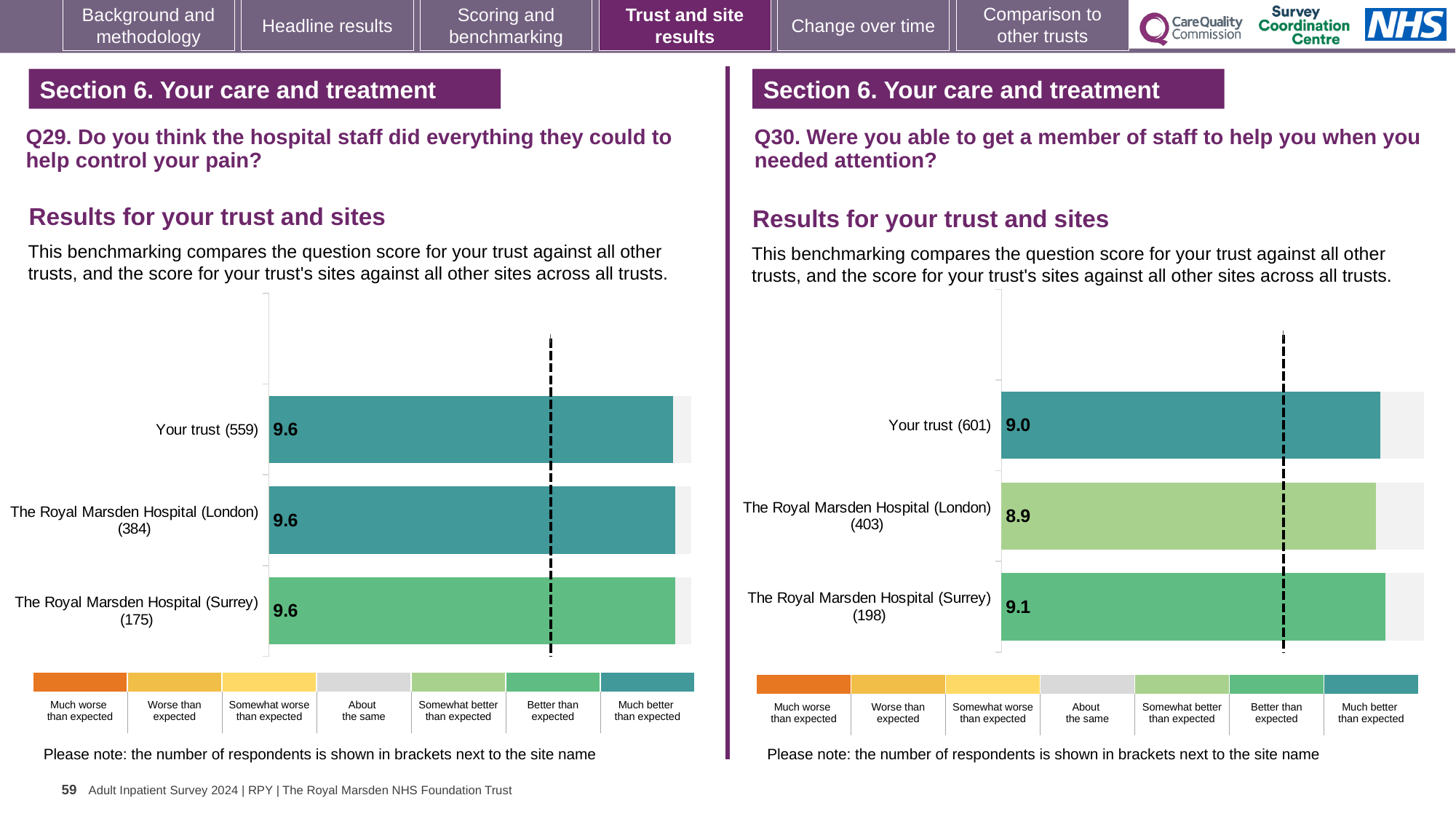
In the Q30 chart on the right, what is the score for Your trust (601)? 9.0 How many bars are plotted in the Q29 chart on the left? 3 In the Q30 chart on the right, which site or trust has the lowest score? The Royal Marsden Hospital (London) (403) In the Q30 chart on the right, what is the score for The Royal Marsden Hospital (London) (403)? 8.9 In the Q30 chart on the right, what is the difference between the Surrey score and the London score? 0.2 In the Q29 chart on the left, what is the score for The Royal Marsden Hospital (Surrey) (175)? 9.6 In the Q30 chart on the right, which benchmark category does the colour of the London bar correspond to according to the legend? Somewhat better than expected In the Q29 chart on the left, what is the score for Your trust (559)? 9.6 What type of chart is used for the Q29 results on the left? Bar chart In the Q30 chart on the right, which site or trust has the highest score? The Royal Marsden Hospital (Surrey) (198) In the Q30 chart on the right, what is the score for The Royal Marsden Hospital (Surrey) (198)? 9.1 In the Q30 chart on the right, is the score for The Royal Marsden Hospital (Surrey) larger or smaller than the score for Your trust? larger